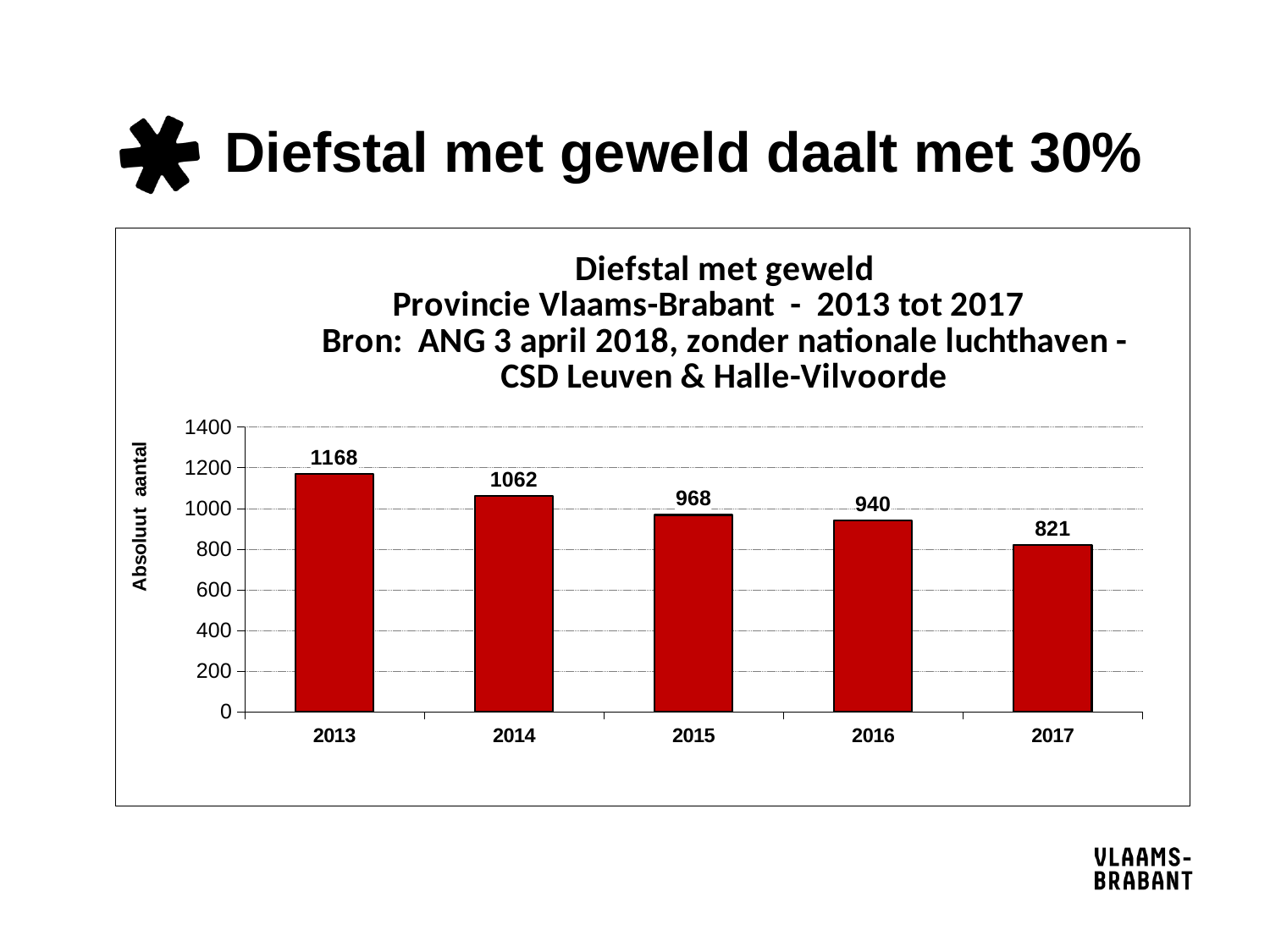
Is the value for 2016 greater or less than 1000? less What kind of chart is shown? bar chart What is the difference between the values for 2013 and 2017? 347 Which is larger, the value for 2015 or the value for 2016? 2015 Which year has the highest value? 2013 What is the value for 2013? 1168 How many years are shown on the x axis? 5 What is the value for 2017? 821 What is the value for 2015? 968 What is the difference between the values for 2014 and 2015? 94 Do the values rise or fall from 2013 to 2017? fall Which year has the lowest value? 2017